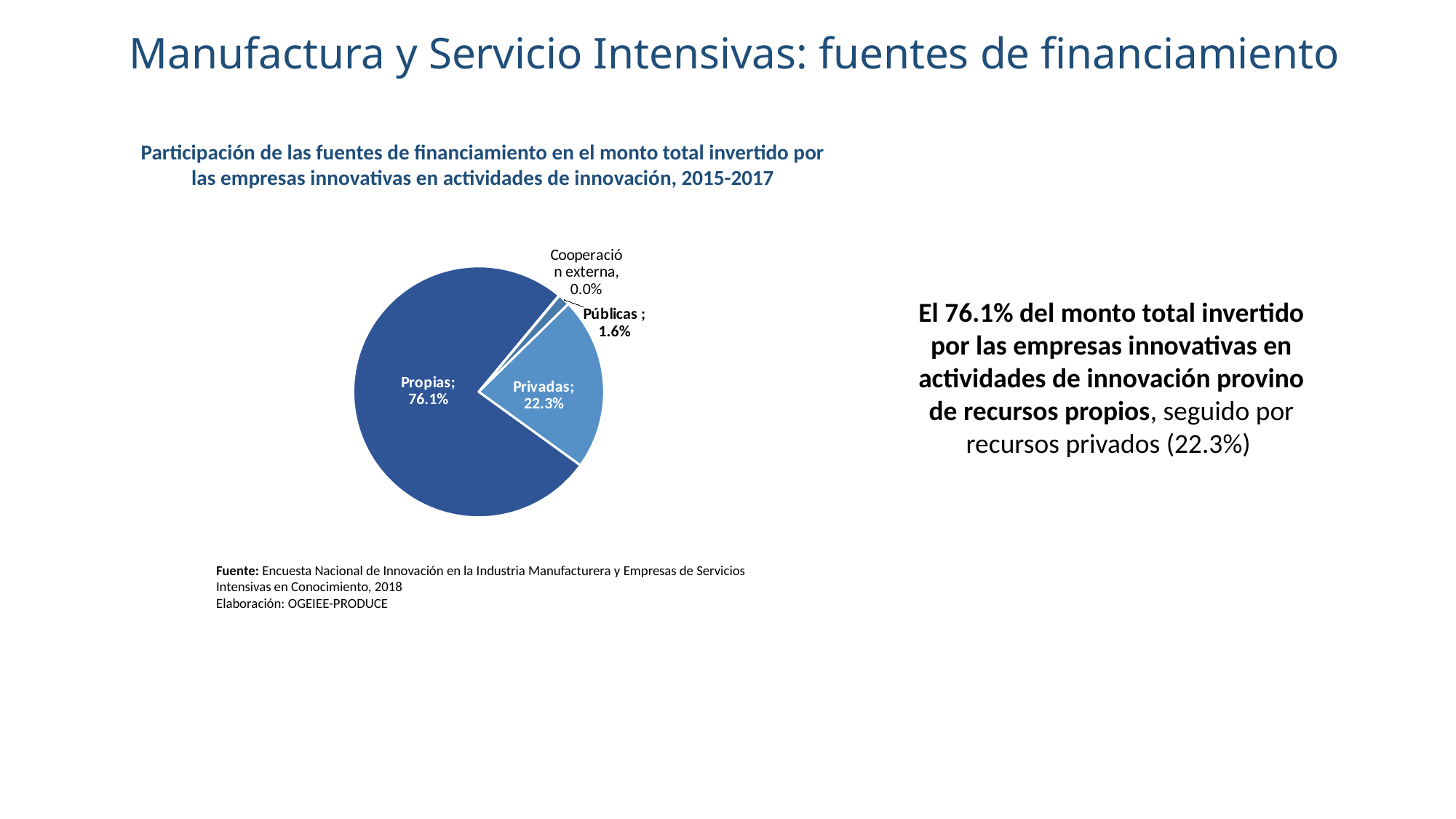
What share of the pie does Públicas represent? 1.6% What is the difference in percentage points between Privadas and Públicas? 20.7 What share of the pie does Privadas represent? 22.3% What share of the pie does Cooperación externa represent? 0.0% What time period does the chart title refer to? 2015-2017 What share of the pie does Propias represent? 76.1% Which is larger, the share for Privadas or the share for Públicas? Privadas How many categories are shown in the pie chart? 4 What is the difference in percentage points between Propias and Privadas? 53.8 Which category has the largest slice of the pie? Propias What kind of chart is shown on the slide? Pie chart Which category has the smallest slice of the pie? Cooperación externa